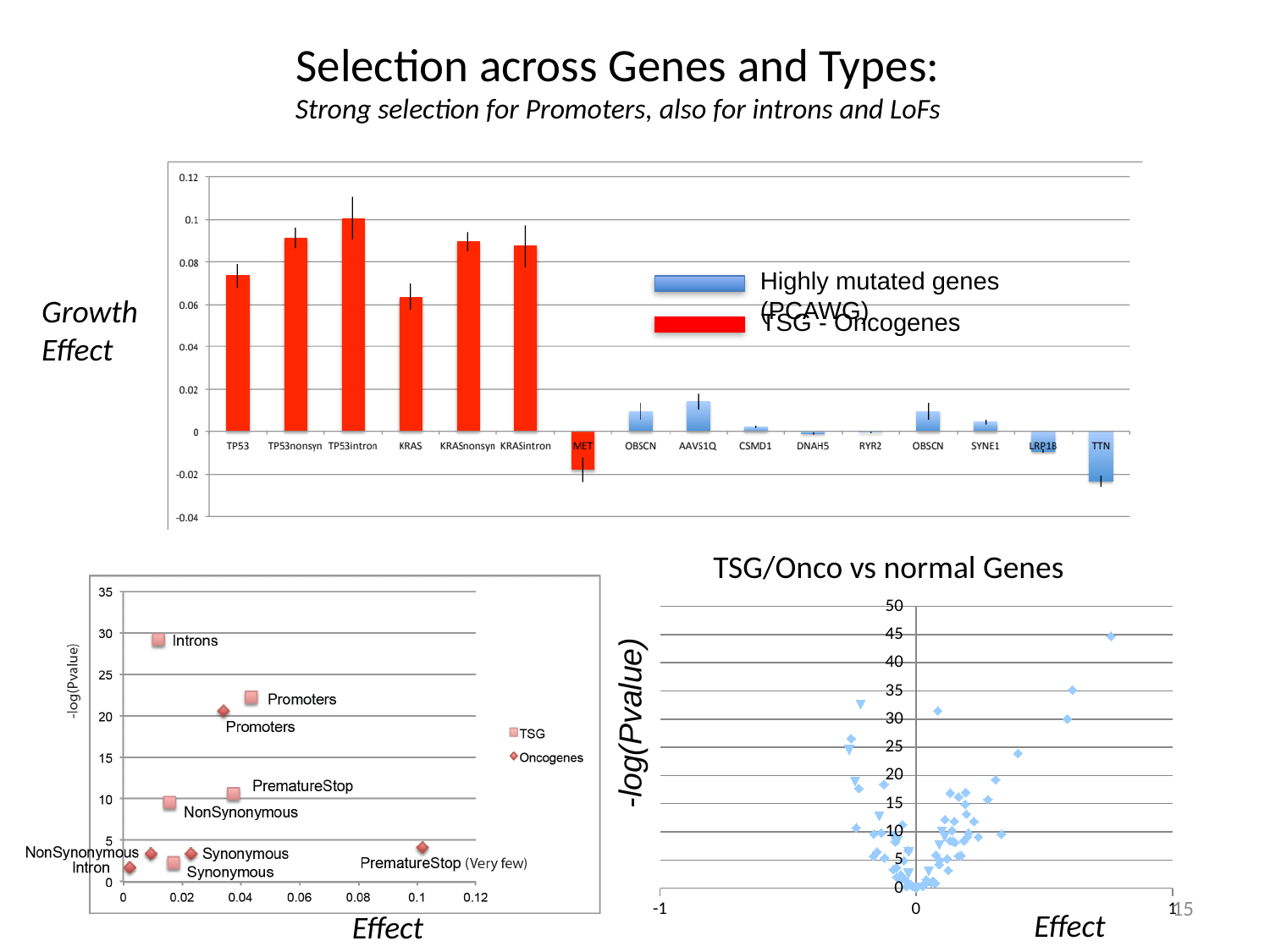
In the bottom-right chart titled 'TSG/Onco vs normal Genes', is the highest point's -log(Pvalue) greater or less than 40? greater In the top chart (Growth Effect), which category has the lowest bar? TTN In the top chart (Growth Effect), what colour are the bars for the TSG - Oncogenes series? Red In the bottom-left chart (Effect vs -log(Pvalue)), how many series does the legend list? 2 In the top chart (Growth Effect), is the value for KRAS greater or less than 0.08? less In the top chart (Growth Effect), which category has the highest bar? TP53intron In the top chart (Growth Effect), is the value for MET greater or less than 0? less In the top chart (Growth Effect), how many categories are shown on the x axis? 16 In the bottom-left chart (Effect vs -log(Pvalue)), which labelled point has the highest -log(Pvalue)? Introns What kind of chart is the bottom-left chart (Effect vs -log(Pvalue))? Scatter chart In the top chart (Growth Effect), how many series does the legend list? 2 In the top chart (Growth Effect), which is larger, the value for TP53 or the value for KRAS? TP53